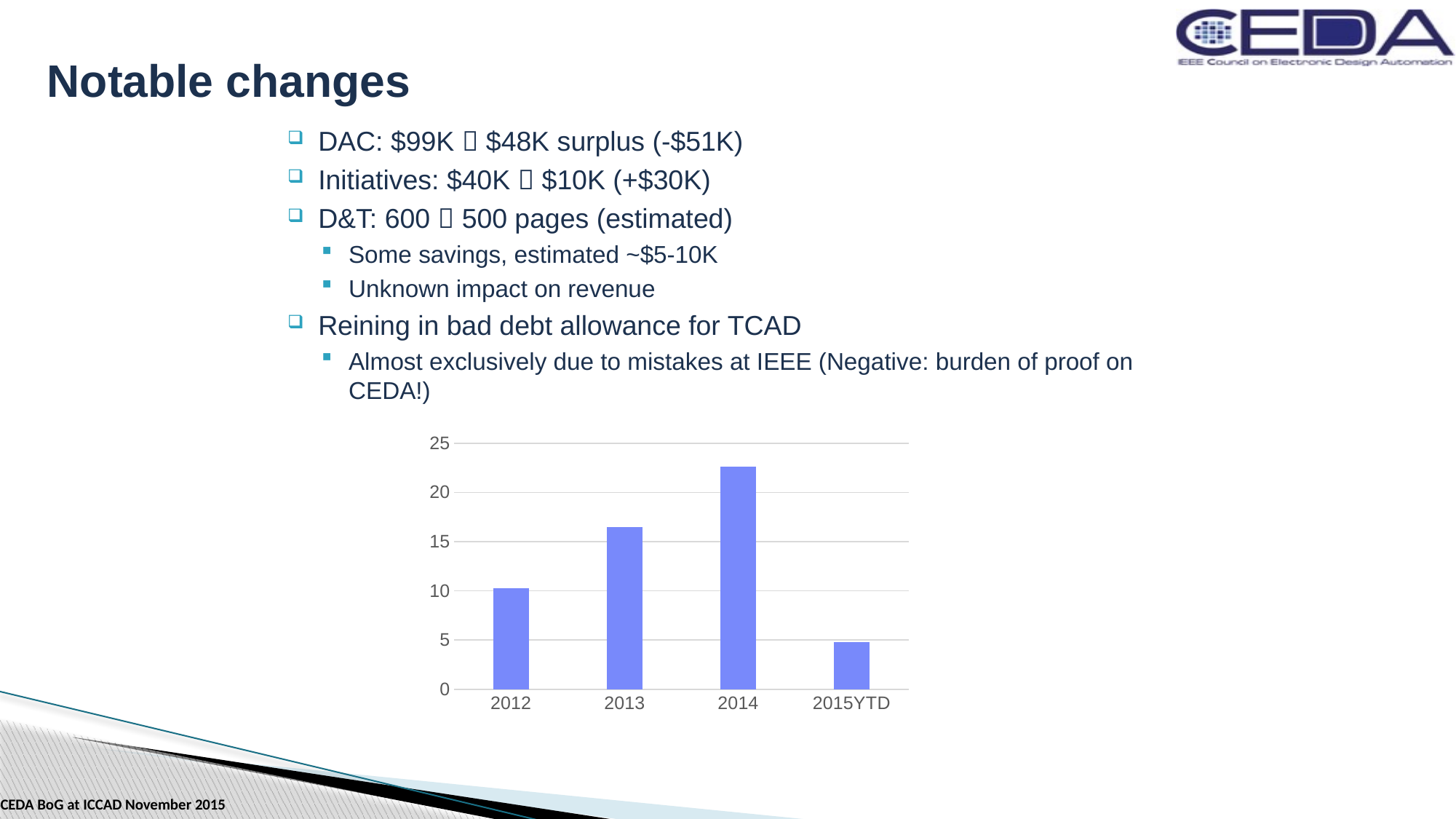
Which category has the highest bar in the chart? 2014 What kind of chart is shown on the slide? Bar chart Which is larger in the chart, the value for 2012 or the value for 2013? 2013 Which category has the lowest bar in the chart? 2015YTD Is the value for 2015YTD greater or less than 10? less Is the value for 2013 greater or less than 15? greater What colour are the bars in the chart? Blue Is the value for 2014 greater or less than 20? greater Which is larger in the chart, the value for 2014 or the value for 2015YTD? 2014 How do the values change from 2012 to 2014 in the chart? They rise How many categories are shown on the x axis of the chart? 4